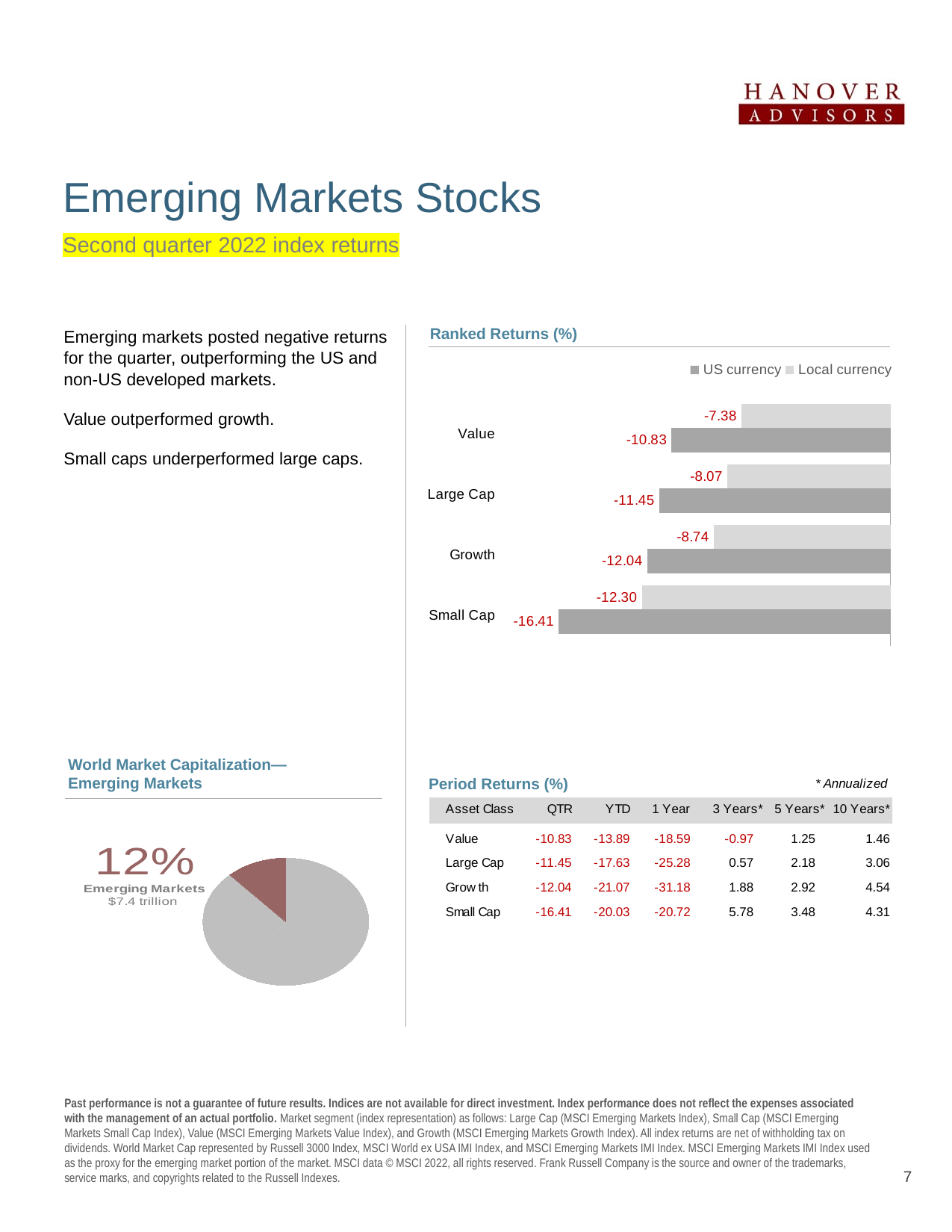
How many series does the legend of the Ranked Returns (%) chart list? 2 In the Ranked Returns (%) chart, which category has the lowest US currency return? Small Cap In the World Market Capitalization—Emerging Markets pie chart, what share of the pie do Emerging Markets represent? 12% In the Ranked Returns (%) chart, which category has the highest Local currency return? Value In the Ranked Returns (%) chart, what is the Local currency return for Growth? -8.74 In the Ranked Returns (%) chart, which is larger: the US currency return for Large Cap or the US currency return for Growth? Large Cap In the Ranked Returns (%) chart, what is the difference between the Local currency and US currency returns for Small Cap? 4.11 In the Ranked Returns (%) chart, what is the US currency return for Small Cap? -16.41 How many categories are shown in the Ranked Returns (%) chart? 4 In the Ranked Returns (%) chart, what is the difference between the Local currency and US currency returns for Value? 3.45 In the Ranked Returns (%) chart, what is the Local currency return for Value? -7.38 What kind of chart is the Ranked Returns (%) chart? Bar chart